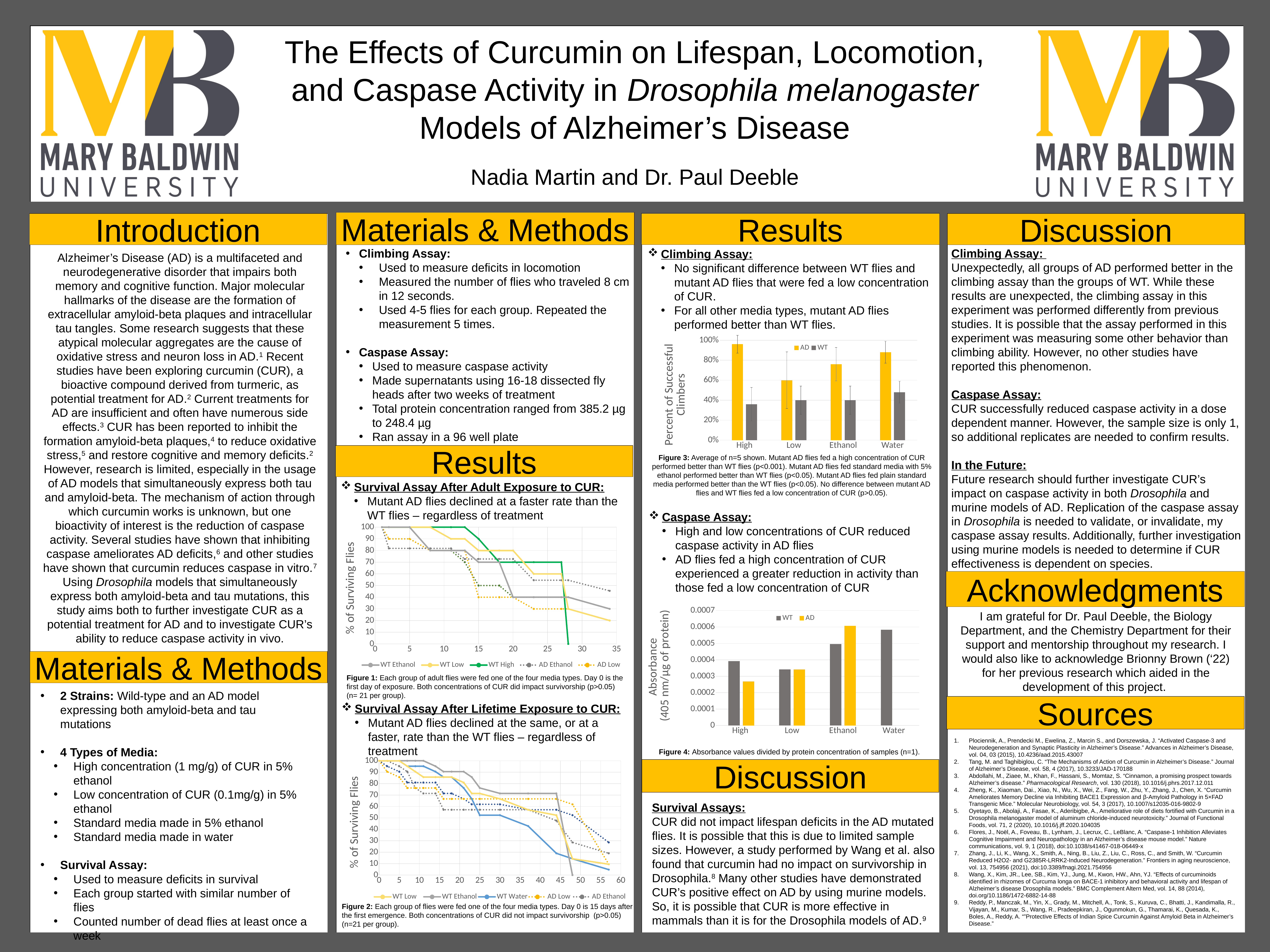
In Figure 3 (Percent of Successful Climbers), for the Low category, which series has the larger value, AD or WT? AD In Figure 3 (Percent of Successful Climbers), which category has the highest AD value? High In Figure 3 (Percent of Successful Climbers), is the AD value for High greater or less than 80%? greater In Figure 1 (Survival Assay After Adult Exposure to CUR), how many series does the legend list? 5 In Figure 3 (Percent of Successful Climbers), what kind of chart is shown? bar chart In Figure 3 (Percent of Successful Climbers), how many media categories are shown on the x axis? 4 In Figure 4 (Absorbance), for the High category, which series has the larger value, WT or AD? WT In Figure 4 (Absorbance), which category has the highest WT value? Water In Figure 3 (Percent of Successful Climbers), is the WT value for High greater or less than 40%? less In Figure 3 (Percent of Successful Climbers), how many series does the legend list? 2 In Figure 1 (Survival Assay After Adult Exposure to CUR), do the % of Surviving Flies values rise or fall as days increase? fall In Figure 4 (Absorbance), what kind of chart is shown? bar chart